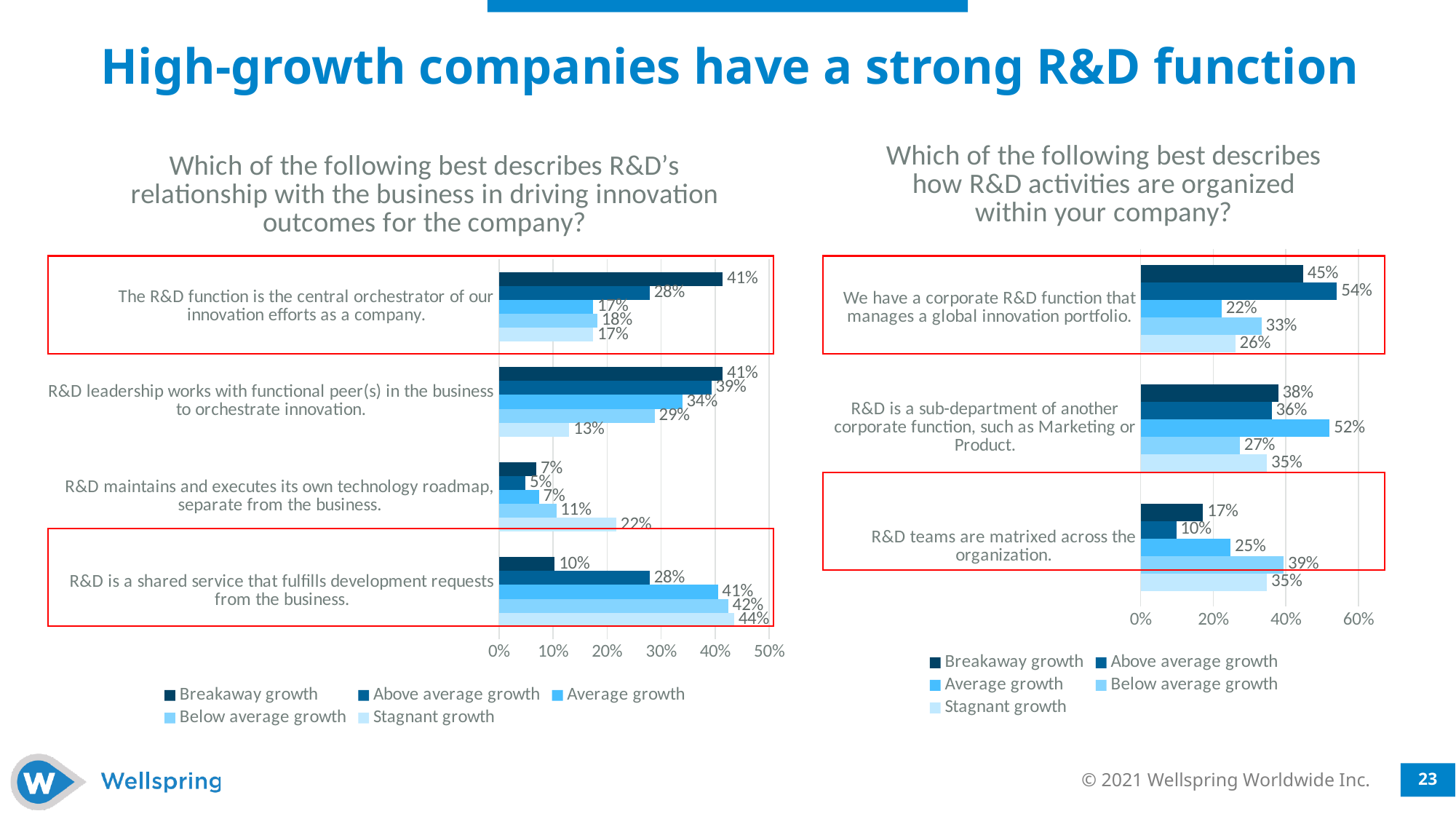
In the left chart (R&D's relationship with the business), what is the difference between the Breakaway growth and Stagnant growth values for "R&D is a shared service that fulfills development requests from the business"? 34% In the right chart (how R&D activities are organized), what is the Above average growth value for "We have a corporate R&D function that manages a global innovation portfolio"? 54% In the left chart (R&D's relationship with the business), what is the Breakaway growth value for "The R&D function is the central orchestrator of our innovation efforts as a company"? 41% In the right chart (how R&D activities are organized), what is the difference between the Above average growth and Average growth values for "We have a corporate R&D function that manages a global innovation portfolio"? 32% In the left chart (R&D's relationship with the business), for "R&D leadership works with functional peer(s) in the business to orchestrate innovation", which is larger: the Average growth value or the Stagnant growth value? Average growth In the right chart (how R&D activities are organized), what is the Average growth value for "R&D is a sub-department of another corporate function, such as Marketing or Product"? 52% In the left chart (R&D's relationship with the business), what is the Stagnant growth value for "R&D is a shared service that fulfills development requests from the business"? 44% In the left chart (R&D's relationship with the business), which growth group has the highest value for "R&D maintains and executes its own technology roadmap, separate from the business"? Stagnant growth How many categories (answer options) are shown in the left chart (R&D's relationship with the business)? 4 What kind of chart is the right chart (how R&D activities are organized)? Bar chart How many series does the legend of the right chart (how R&D activities are organized) list? 5 In the right chart (how R&D activities are organized), which growth group has the lowest value for "R&D teams are matrixed across the organization"? Above average growth